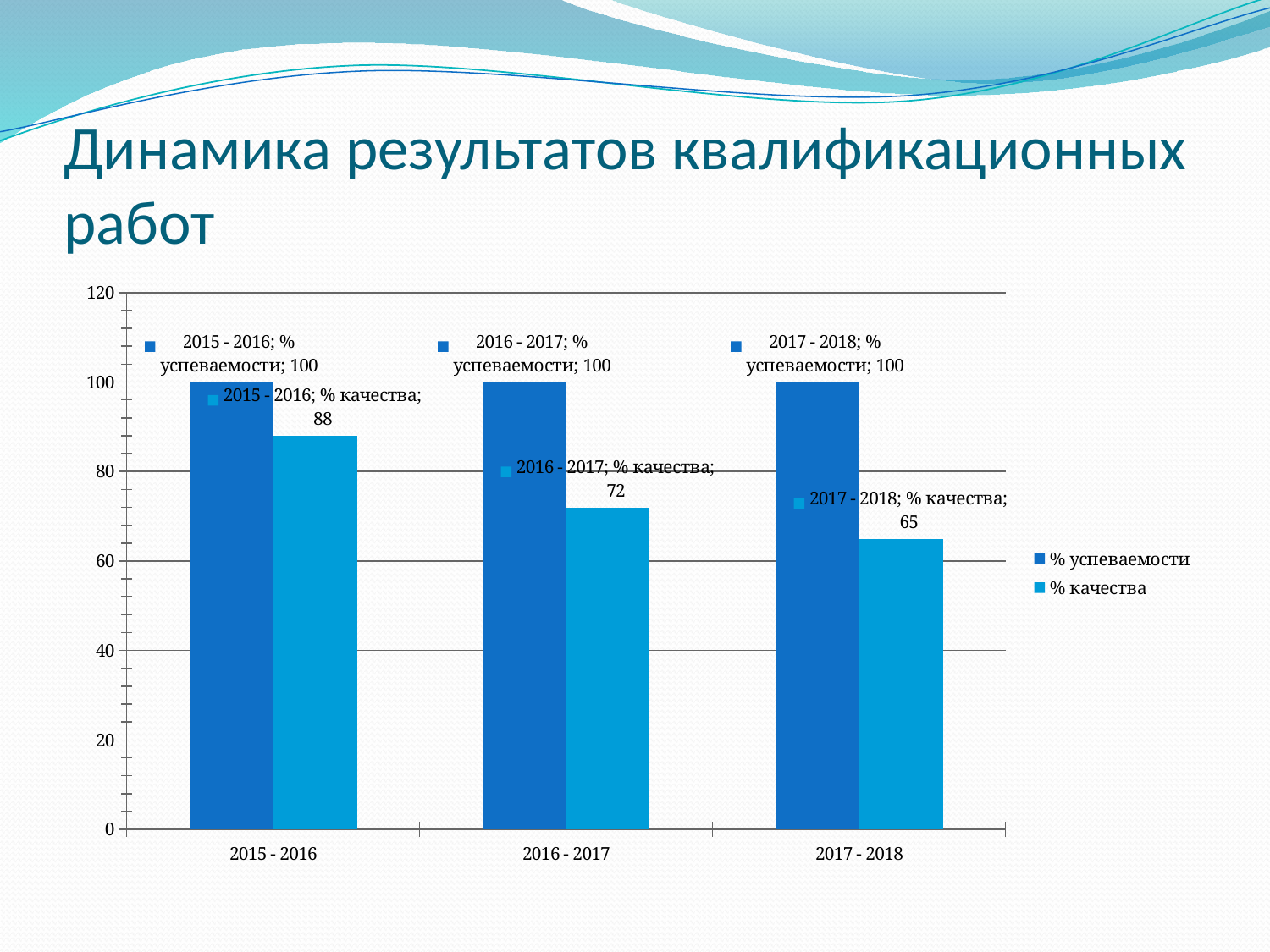
What is the value of % качества for 2016 - 2017? 72 What is the value of % успеваемости for 2016 - 2017? 100 How many series does the legend list? 2 Which is larger: % качества for 2016 - 2017 or for 2017 - 2018? 2016 - 2017 How many year categories are shown on the x axis? 3 What is the value of % качества for 2015 - 2016? 88 What is the value of % качества for 2017 - 2018? 65 Which year has the lowest value of % качества? 2017 - 2018 Which year has the highest value of % качества? 2015 - 2016 Does % качества rise or fall from 2015 - 2016 to 2017 - 2018? Fall What is the difference between % качества for 2015 - 2016 and 2017 - 2018? 23 What kind of chart is shown on the slide? Bar chart